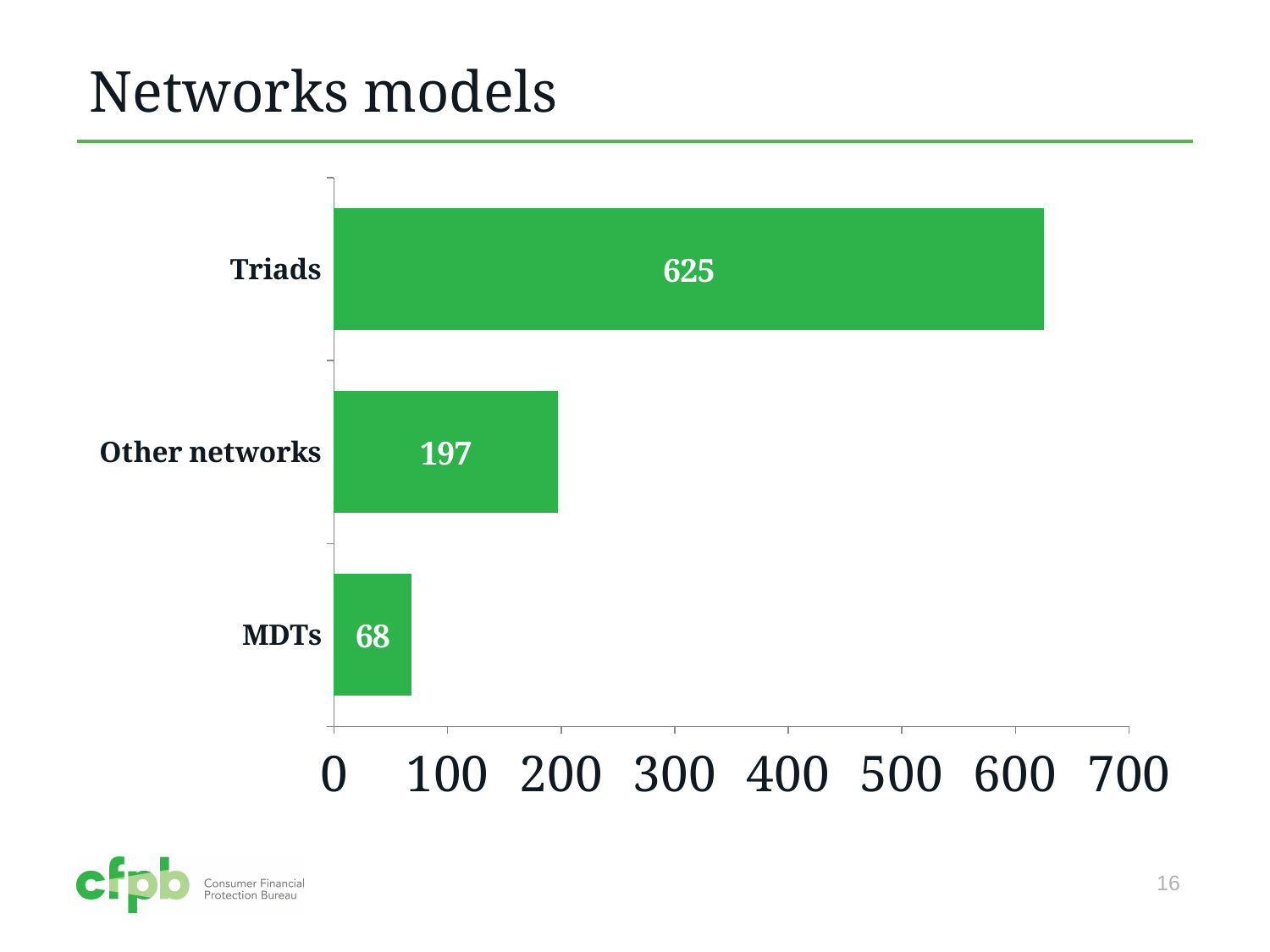
Which is larger, the value for Other networks or the value for MDTs? Other networks Which category has the highest value? Triads What is the value for Other networks? 197 What is the value for Triads? 625 How many categories are shown in the chart? 3 What kind of chart is shown on the slide? bar chart What is the value for MDTs? 68 What is the difference between the values for Other networks and MDTs? 129 Which category has the lowest value? MDTs Is the value for Triads greater or less than 600? greater What is the title of the slide containing the chart? Networks models What is the difference between the values for Triads and Other networks? 428